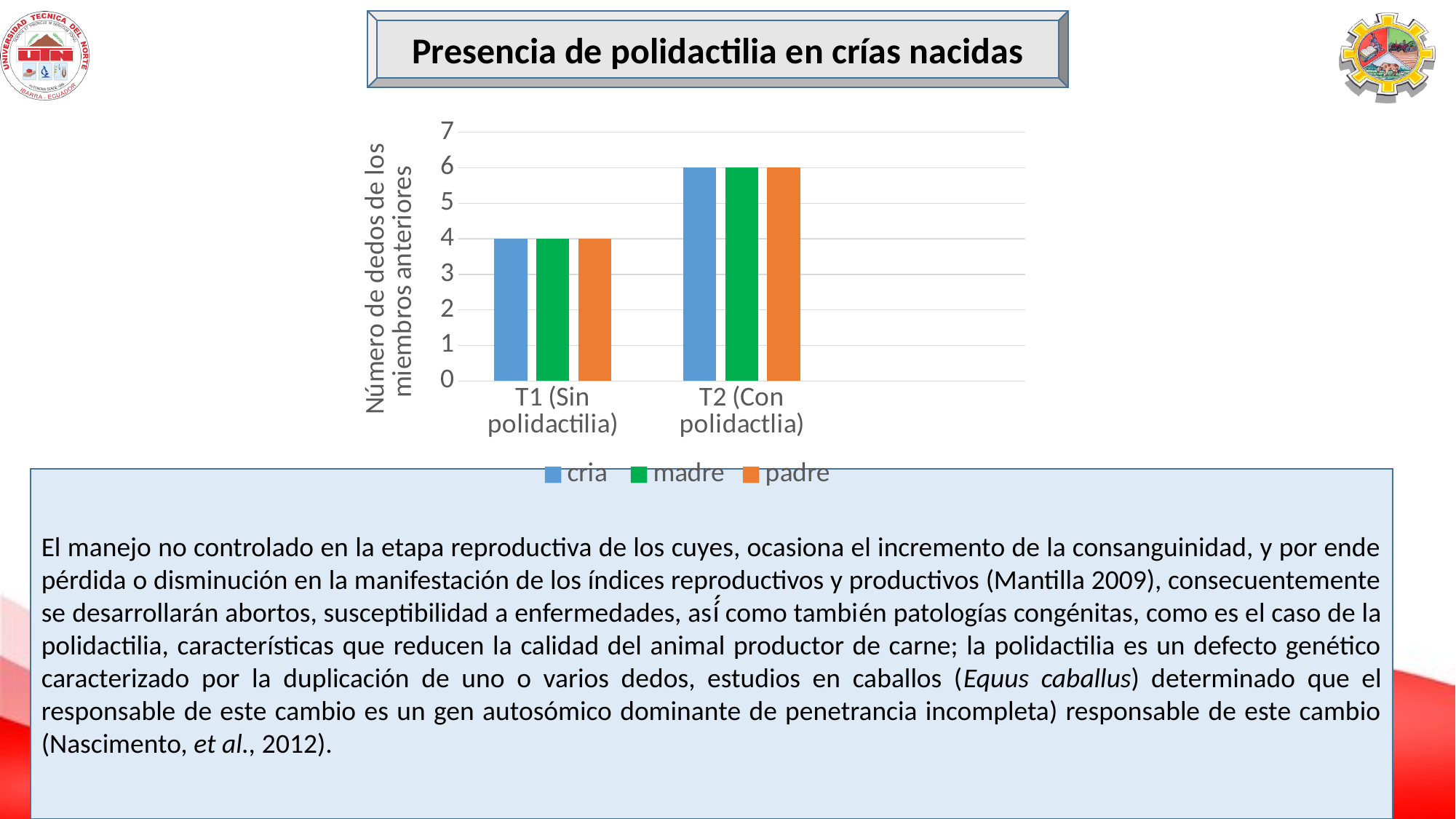
What kind of chart is shown on the slide? bar chart What is the title of the chart? Presencia de polidactilia en crías nacidas What is the value for madre in T2 (Con polidactlia)? 6 How many series does the legend list? 3 Which category has the higher value for cria, T1 (Sin polidactilia) or T2 (Con polidactlia)? T2 (Con polidactlia) What is the value for cria in T1 (Sin polidactilia)? 4 What is the label of the y axis? Número de dedos de los miembros anteriores Is the value for madre in T2 (Con polidactlia) greater or less than 5? greater How many categories are shown on the x axis? 2 What is the difference between the padre value in T2 (Con polidactlia) and in T1 (Sin polidactilia)? 2 What is the value for padre in T1 (Sin polidactilia)? 4 Do the values rise or fall from T1 (Sin polidactilia) to T2 (Con polidactlia)? rise